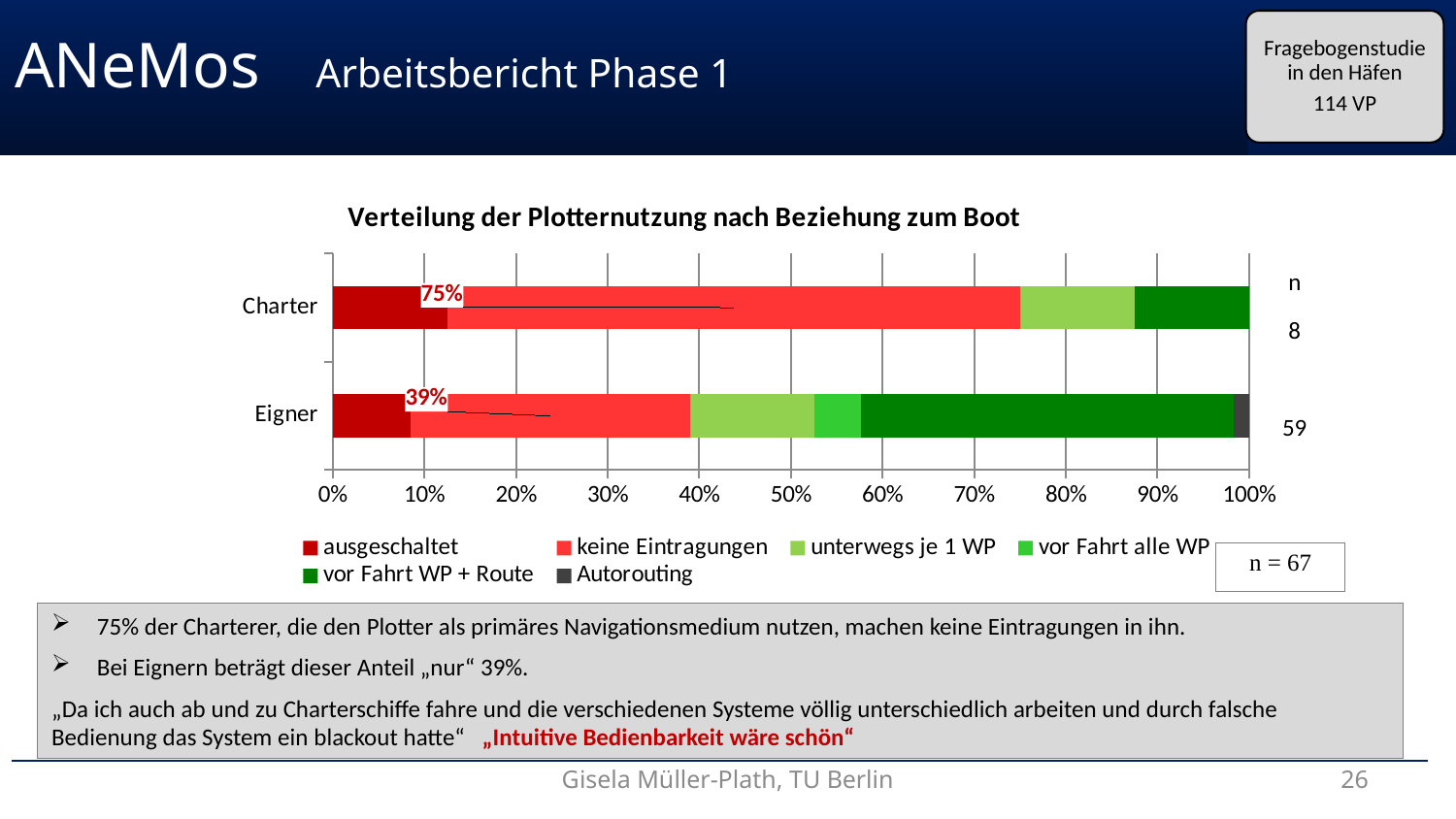
What is the n (number of respondents) shown next to the Charter bar? 8 Which category has the larger 'keine Eintragungen' share, Charter or Eigner? Charter How many series does the legend list? 6 What is the chart's title? Verteilung der Plotternutzung nach Beziehung zum Boot How many categories (boat relationships) are plotted on the y axis? 2 Is the 'vor Fahrt WP + Route' share for Eigner greater or less than 30%? greater What share of Charter respondents falls into 'keine Eintragungen'? 75% What is the n (number of respondents) shown next to the Eigner bar? 59 What kind of chart is shown on the slide? Stacked horizontal bar chart Is the 'ausgeschaltet' share for Charter greater or less than 20%? less By how many percentage points does the 'keine Eintragungen' share for Charter exceed that for Eigner? 36 percentage points What share of Eigner respondents falls into 'keine Eintragungen'? 39%